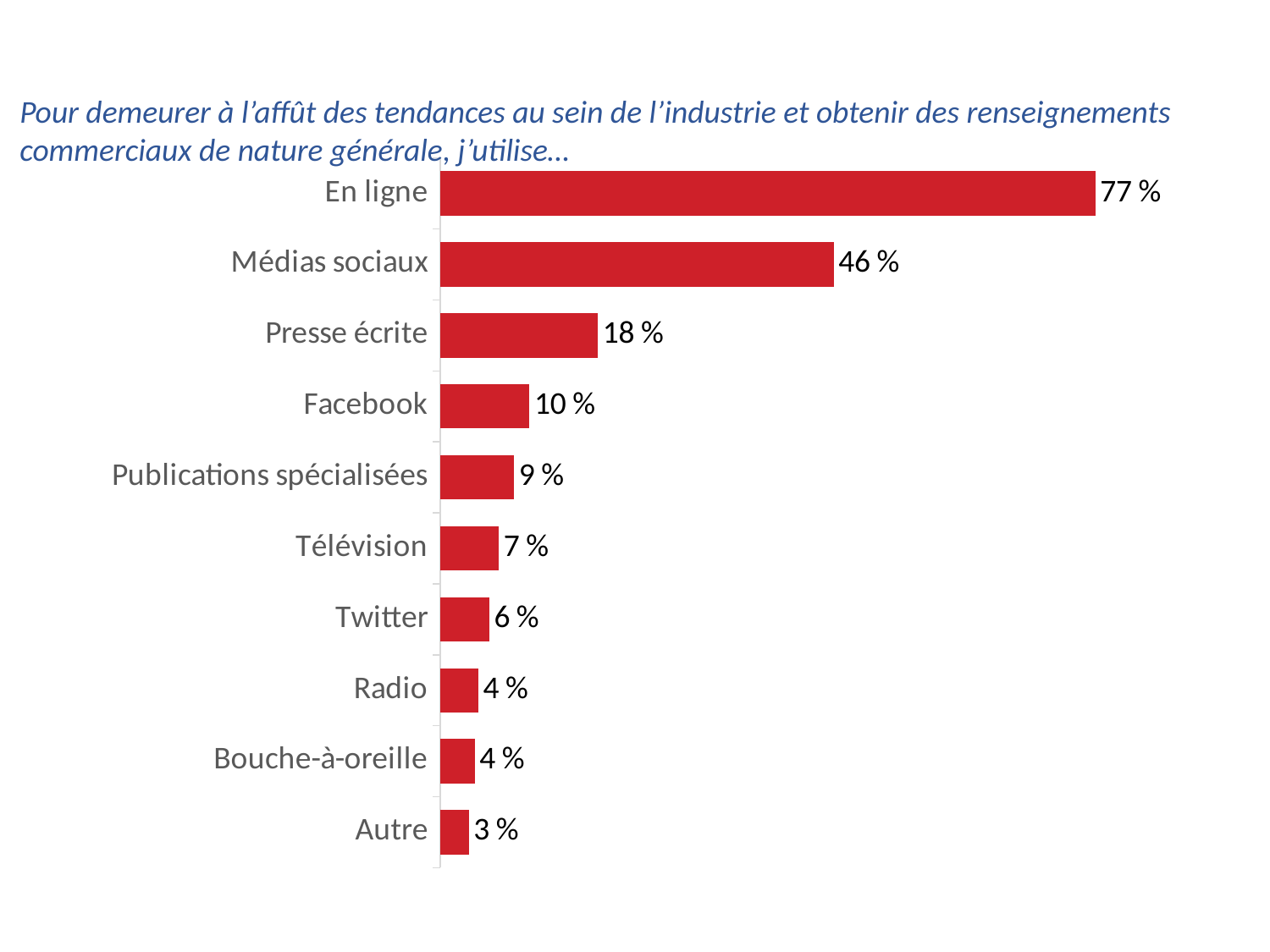
What is the value for Publications spécialisées? 9 % How many categories are shown in the chart? 10 What colour are the bars in the chart? Red What is the value for Médias sociaux? 46 % What is the value for En ligne? 77 % Which category has the lowest value? Autre Which category has the highest value? En ligne What is the value for Twitter? 6 % What kind of chart is shown on the slide? Bar chart Which is larger, the value for Télévision or the value for Radio? Télévision What is the difference between the values for Presse écrite and Facebook? 8 % What is the difference between the values for En ligne and Médias sociaux? 31 %